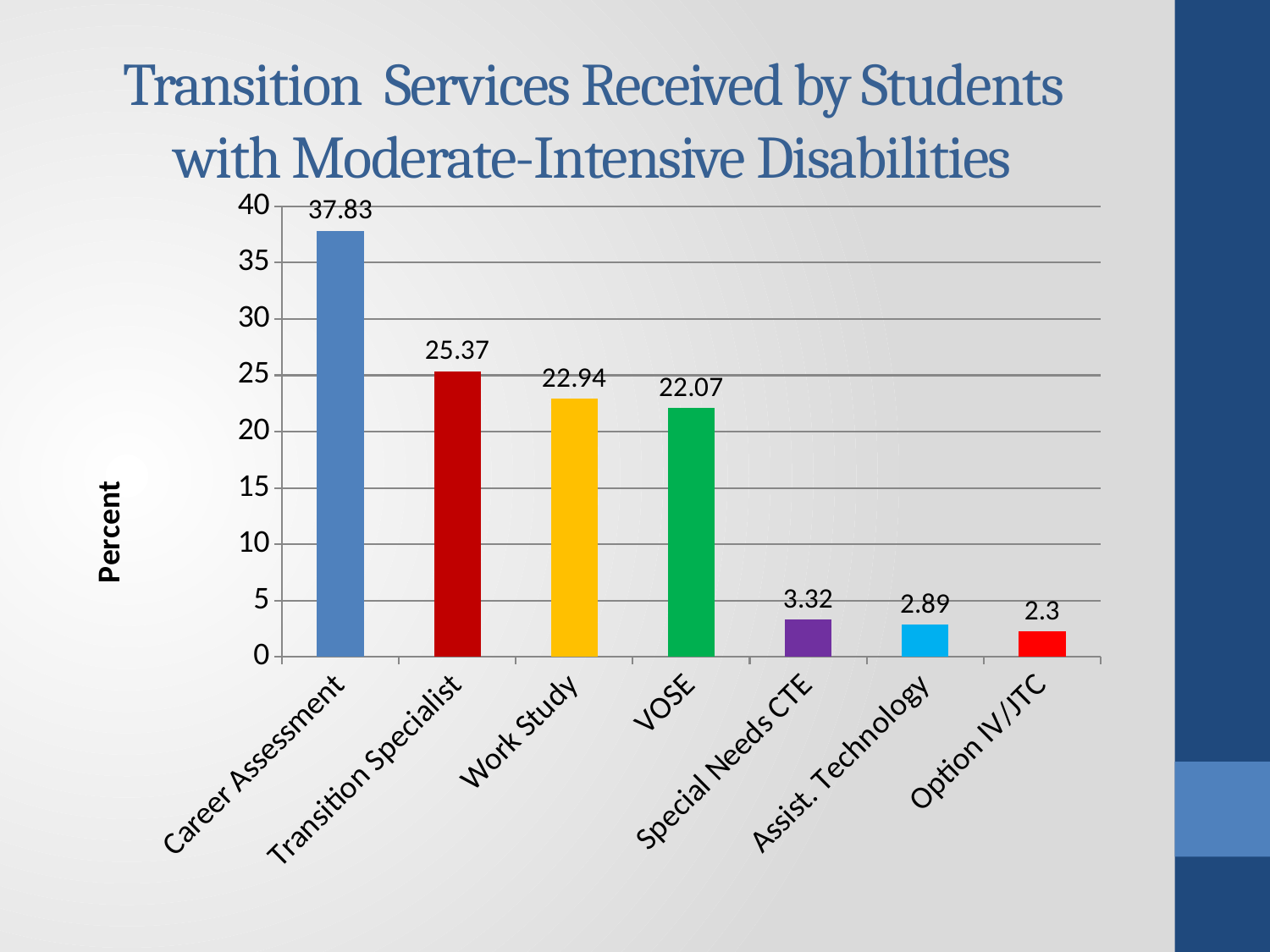
Which category has the lowest value? Option IV/JTC What is the difference between the values for Work Study and VOSE? 0.87 What is the value for Career Assessment? 37.83 Which is larger, the value for Special Needs CTE or the value for Option IV/JTC? Special Needs CTE What is the difference between the values for Career Assessment and Transition Specialist? 12.46 What is the label of the vertical axis? Percent Is the value for Transition Specialist greater or less than 25? greater What kind of chart is shown on the slide? bar chart What is the value for VOSE? 22.07 Which category has the highest value? Career Assessment What is the value for Assist. Technology? 2.89 How many categories are shown on the x axis? 7